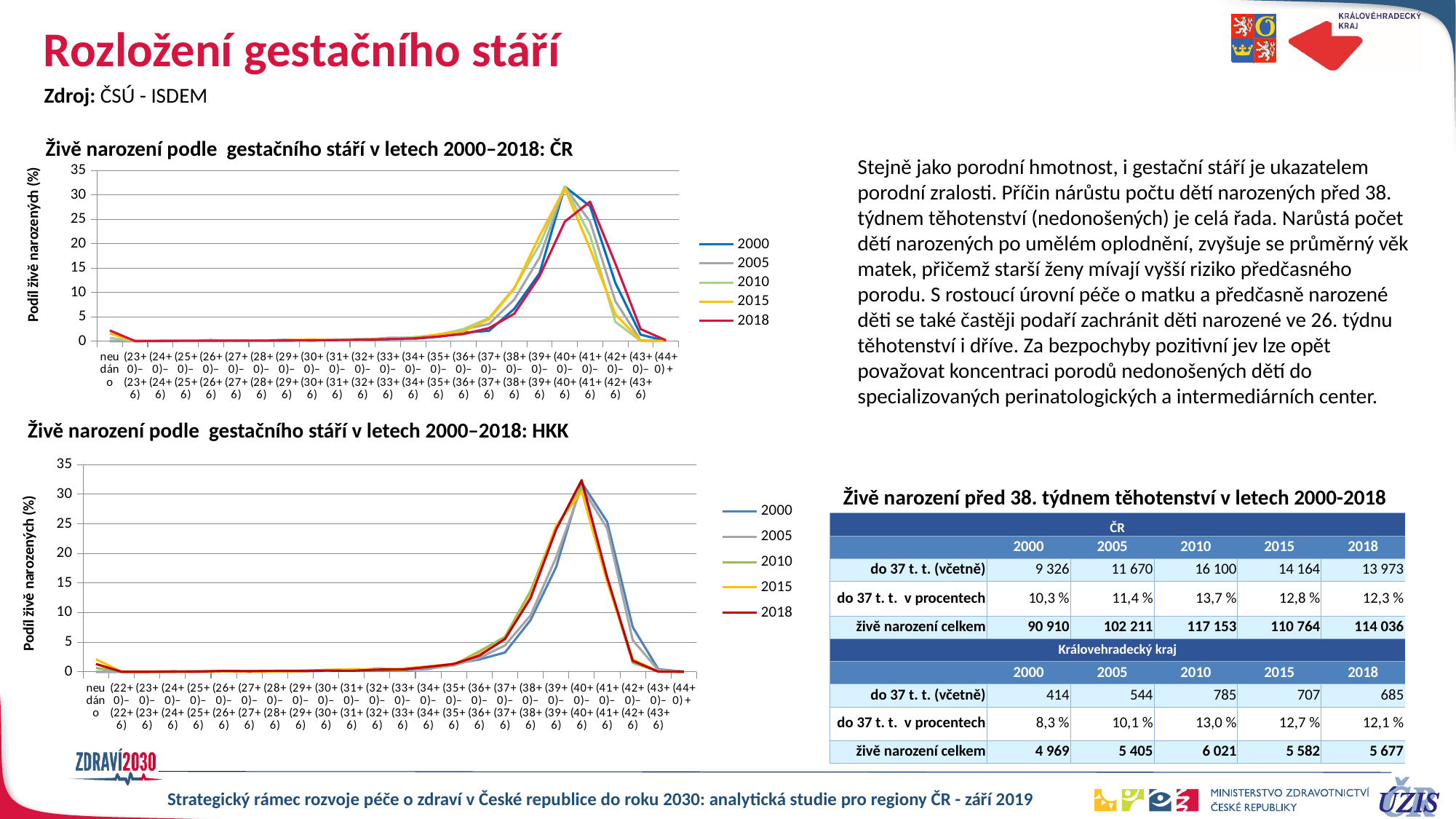
In the chart "Živě narození podle gestačního stáří v letech 2000–2018: ČR", at (41+0)–(41+6), which series has the larger value, 2018 or 2015? 2018 What kind of chart is the chart titled "Živě narození podle gestačního stáří v letech 2000–2018: ČR"? line chart How many series does the legend of the chart "Živě narození podle gestačního stáří v letech 2000–2018: HKK" list? 5 In the chart "Živě narození podle gestačního stáří v letech 2000–2018: HKK", is the 2000 value for (41+0)–(41+6) greater or less than 20? greater In the chart "Živě narození podle gestačního stáří v letech 2000–2018: ČR", is the 2018 value for (41+0)–(41+6) greater or less than 30? less In the chart "Živě narození podle gestačního stáří v letech 2000–2018: ČR", which gestational age category has the highest value for the 2018 series? (41+0)–(41+6) In the chart "Živě narození podle gestačního stáří v letech 2000–2018: HKK", is the 2018 value for (40+0)–(40+6) greater or less than 30? greater In the chart "Živě narození podle gestačního stáří v letech 2000–2018: HKK", which gestational age category has the highest value for the 2018 series? (40+0)–(40+6) What is the y-axis label of the chart "Živě narození podle gestačního stáří v letech 2000–2018: HKK"? Podíl živě narozených (%) Which years are listed in the legend of the chart "Živě narození podle gestačního stáří v letech 2000–2018: ČR"? 2000, 2005, 2010, 2015, 2018